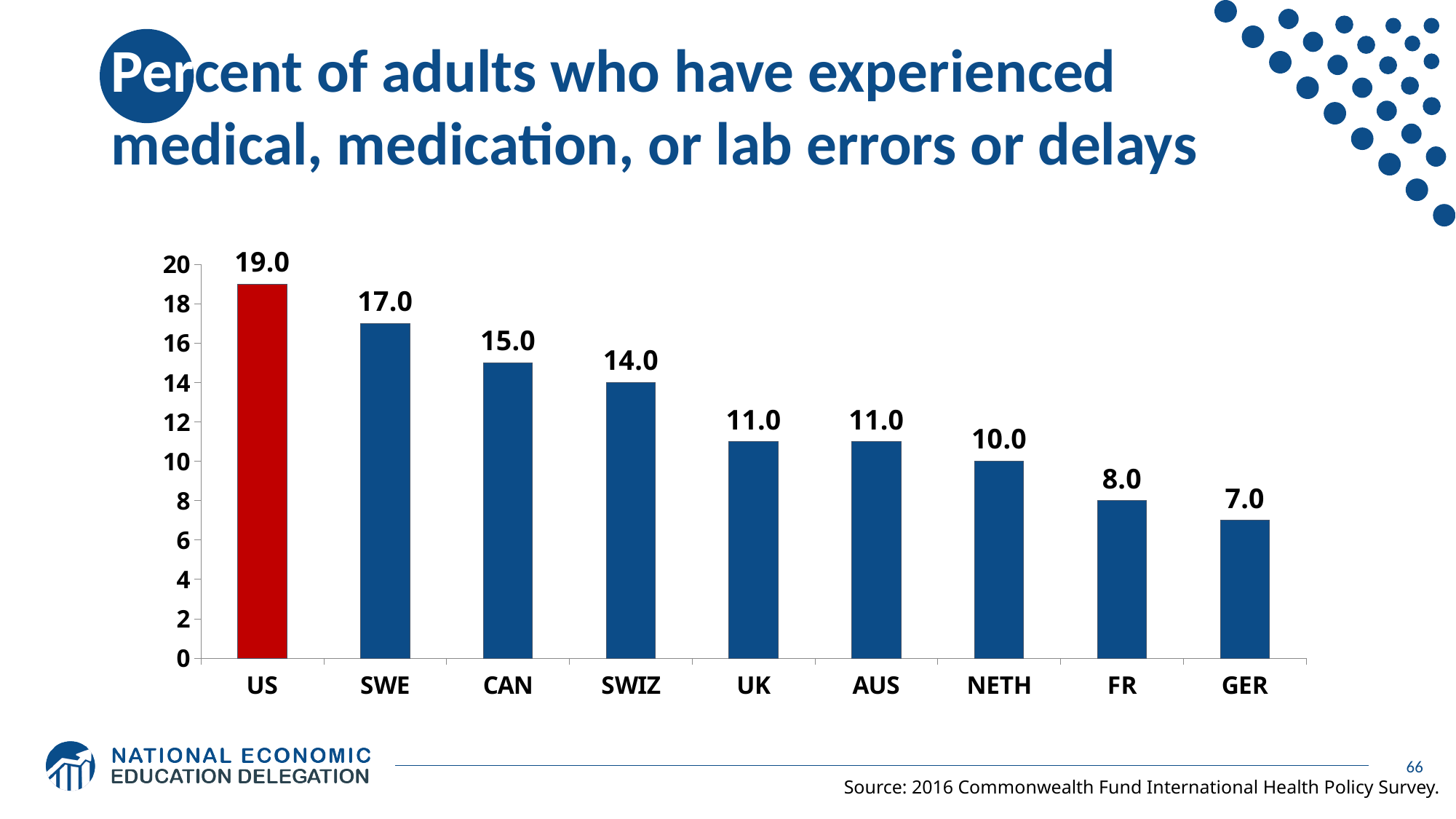
What is the value for SWIZ? 14.0 What is the value for the US? 19.0 Which is larger, the value for FR or the value for NETH? NETH Do the values rise or fall moving from left to right along the x axis? Fall Which country has the highest value? US How many countries are shown on the chart? 9 What is the difference between the values for the US and SWE? 2.0 What is the value for NETH? 10.0 What kind of chart is shown on the slide? Bar chart Which bar is coloured red rather than blue? US What is the difference between the values for CAN and GER? 8.0 Which country has the lowest value? GER